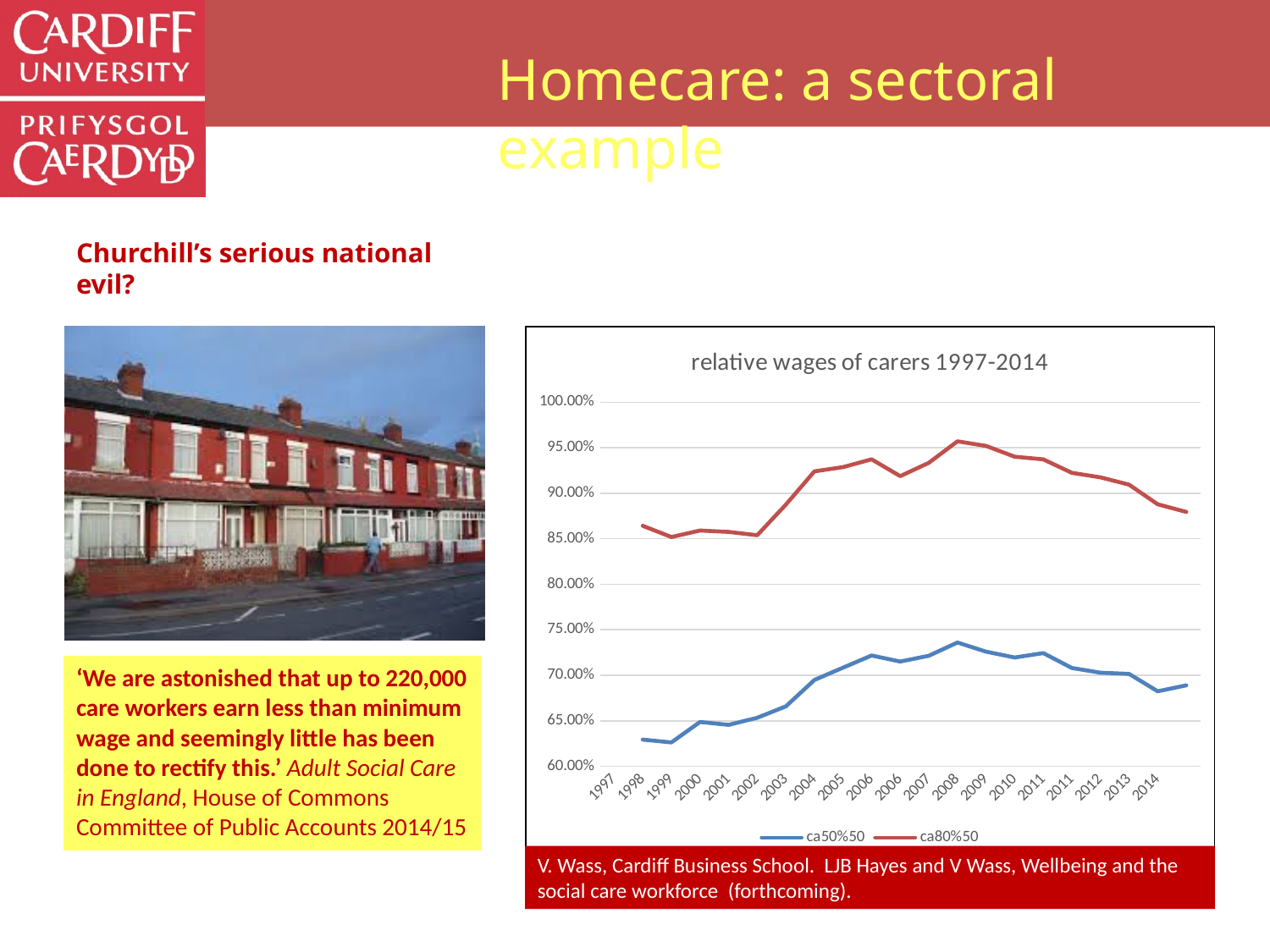
What kind of chart is shown on the slide? line chart Does the ca50%50 series rise or fall between 1997 and 2008? rise Is the value of the ca50%50 series in 2014 greater or less than 70.00%? less Is the value of the ca80%50 series in 2004 greater or less than 90.00%? greater Is the value of the ca80%50 series in 2014 greater or less than 90.00%? less What is the title of the chart? relative wages of carers 1997-2014 Does the ca80%50 series rise or fall between 2008 and 2014? fall In 2008, which series has the higher value, ca50%50 or ca80%50? ca80%50 How many series does the chart legend list? 2 Which series is drawn in red in the chart? ca80%50